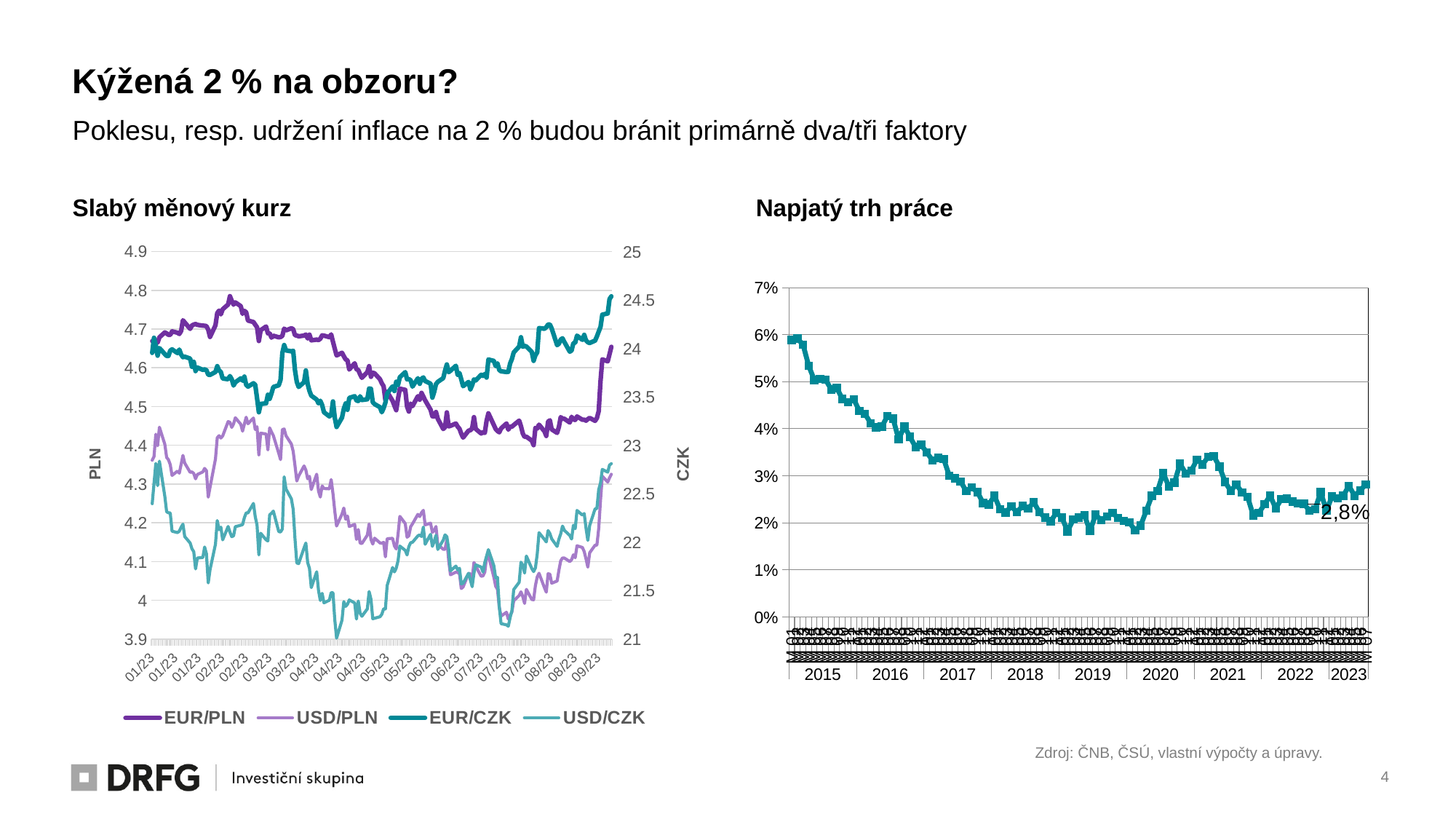
In the 'Slabý měnový kurz' chart, is the lowest USD/CZK value (around 04/23) greater or less than 21.5? less In the 'Napjatý trh práce' chart, what is the value shown by the data label at the end of the series? 2,8% In the 'Slabý měnový kurz' chart, does the EUR/CZK series end higher or lower than it starts? higher In the 'Napjatý trh práce' chart, do the values rise or fall from 2015 to 2019? fall In the 'Slabý měnový kurz' chart, is the EUR/CZK value at the end of the period (09/23) greater or less than 24? greater In the 'Napjatý trh práce' chart, is the value at the start of 2015 greater or less than 5%? greater In the 'Slabý měnový kurz' chart, what is the title of the right vertical axis? CZK In the 'Slabý měnový kurz' chart, what is the title of the left vertical axis? PLN What kind of chart is the 'Slabý měnový kurz' chart? line chart How many series does the legend of the 'Slabý měnový kurz' chart list? 4 What kind of chart is the 'Napjatý trh práce' chart? line chart